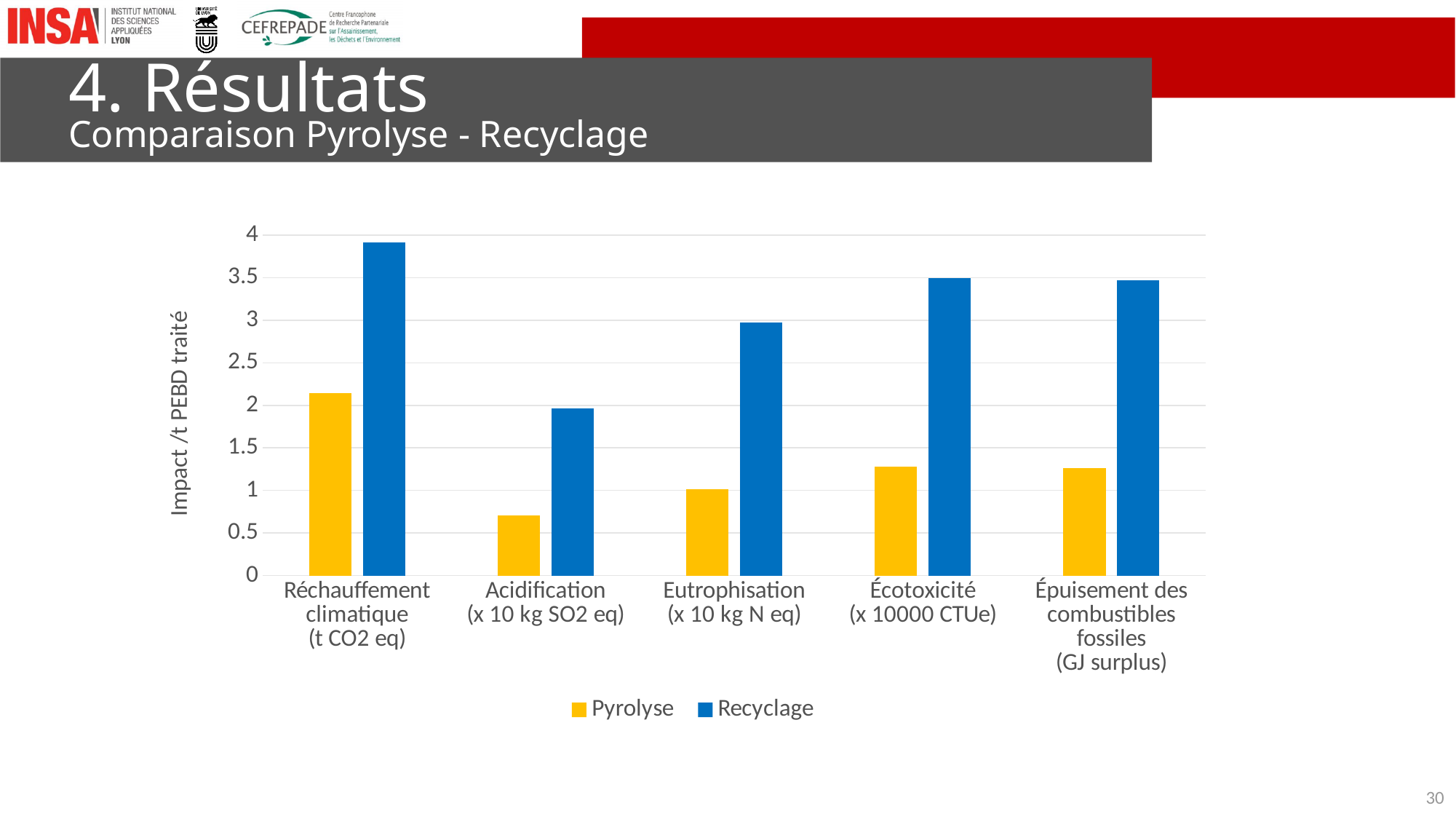
For Eutrophisation, which is larger: the Pyrolyse value or the Recyclage value? Recyclage How many impact categories are shown on the x axis? 5 How many series does the legend list? 2 What is the label of the vertical axis? Impact /t PEBD traité Is the Recyclage value for Réchauffement climatique greater or less than 3.5? greater Is the Pyrolyse value for Réchauffement climatique greater or less than 2? greater Is the Pyrolyse value for Acidification greater or less than 1? less For which category is the Pyrolyse value highest? Réchauffement climatique (t CO2 eq) For which category is the Recyclage value lowest? Acidification (x 10 kg SO2 eq) For which category is the Recyclage value highest? Réchauffement climatique (t CO2 eq) For which category is the Pyrolyse value lowest? Acidification (x 10 kg SO2 eq) What kind of chart is shown on the slide? Bar chart